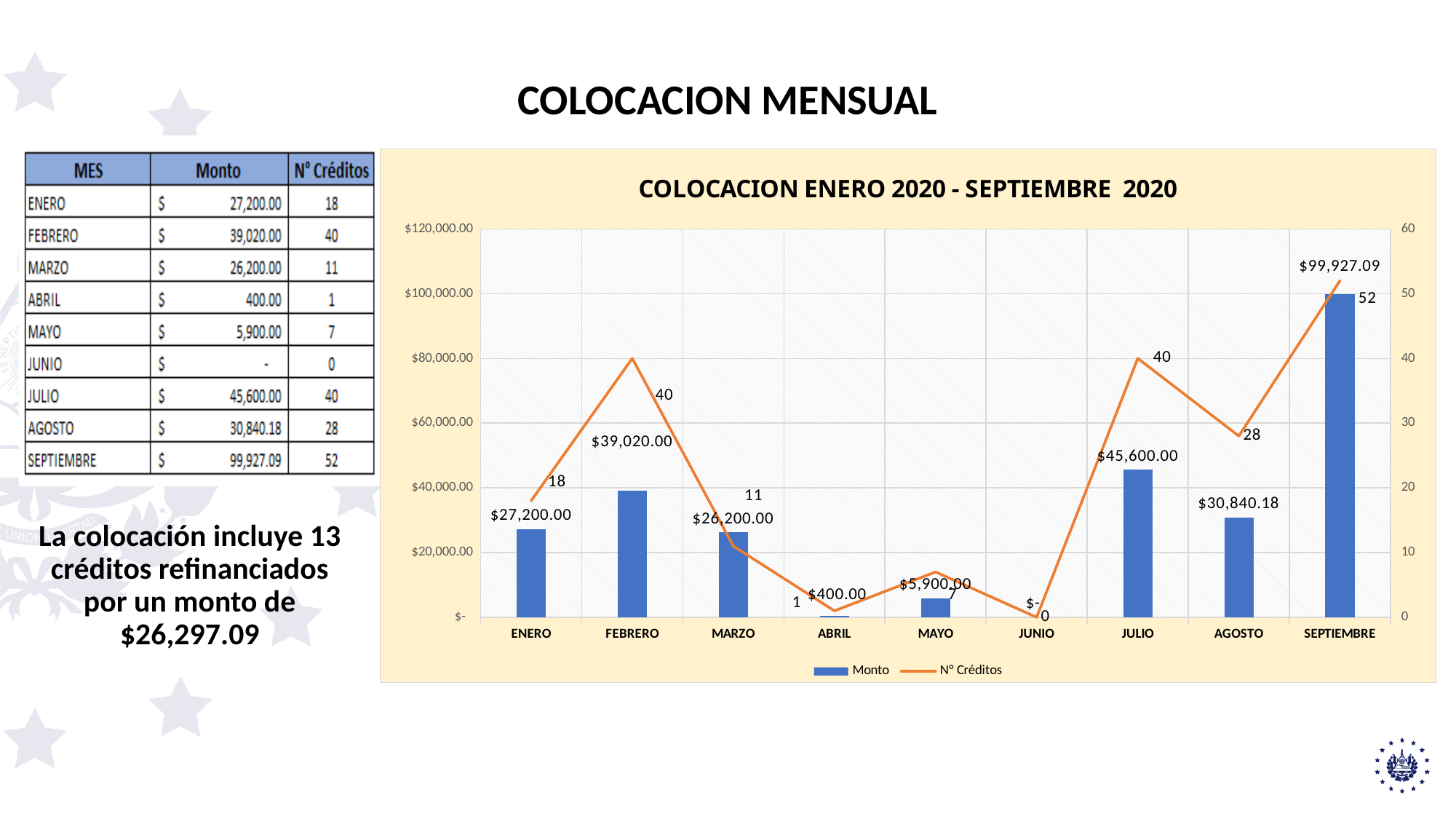
What is the difference in Monto between JULIO and FEBRERO? $6,580.00 Which month has the highest Monto? SEPTIEMBRE What is the title of the chart? COLOCACION ENERO 2020 - SEPTIEMBRE 2020 What is the N° Créditos value for FEBRERO? 40 Is the Monto for JULIO greater or less than $40,000.00? greater What is the Monto value for AGOSTO? $30,840.18 What kind of chart is used to show the Monto series? bar chart Which month has the lowest N° Créditos? JUNIO Which is larger, the Monto for ENERO or the Monto for MARZO? ENERO What is the Monto value for SEPTIEMBRE? $99,927.09 How many months are shown on the x axis? 9 How many series does the legend list? 2